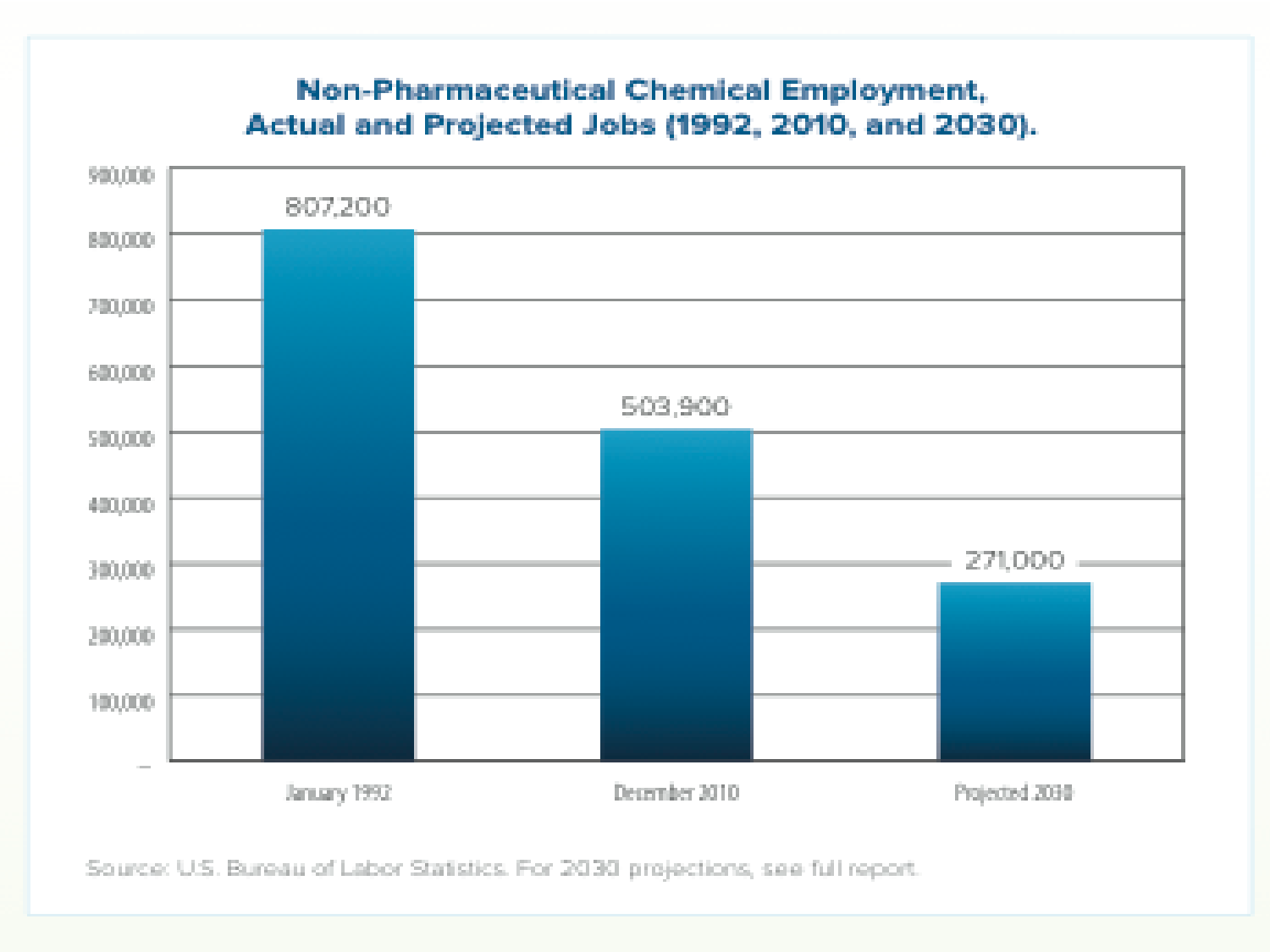
What kind of chart is shown on the slide? bar chart Which category has the highest value? January 1992 What is the difference between the values for December 2010 and Projected 2030? 232,900 Which is larger, the value for December 2010 or the value for Projected 2030? December 2010 Do the values rise or fall from January 1992 to Projected 2030? fall Which category has the lowest value? Projected 2030 What is the difference between the values for January 1992 and December 2010? 303,300 What is the value for Projected 2030? 271,000 What is the value for December 2010? 503,900 What is the value for January 1992? 807,200 Is the value for Projected 2030 greater or less than 300,000? less How many categories are shown on the x axis? 3